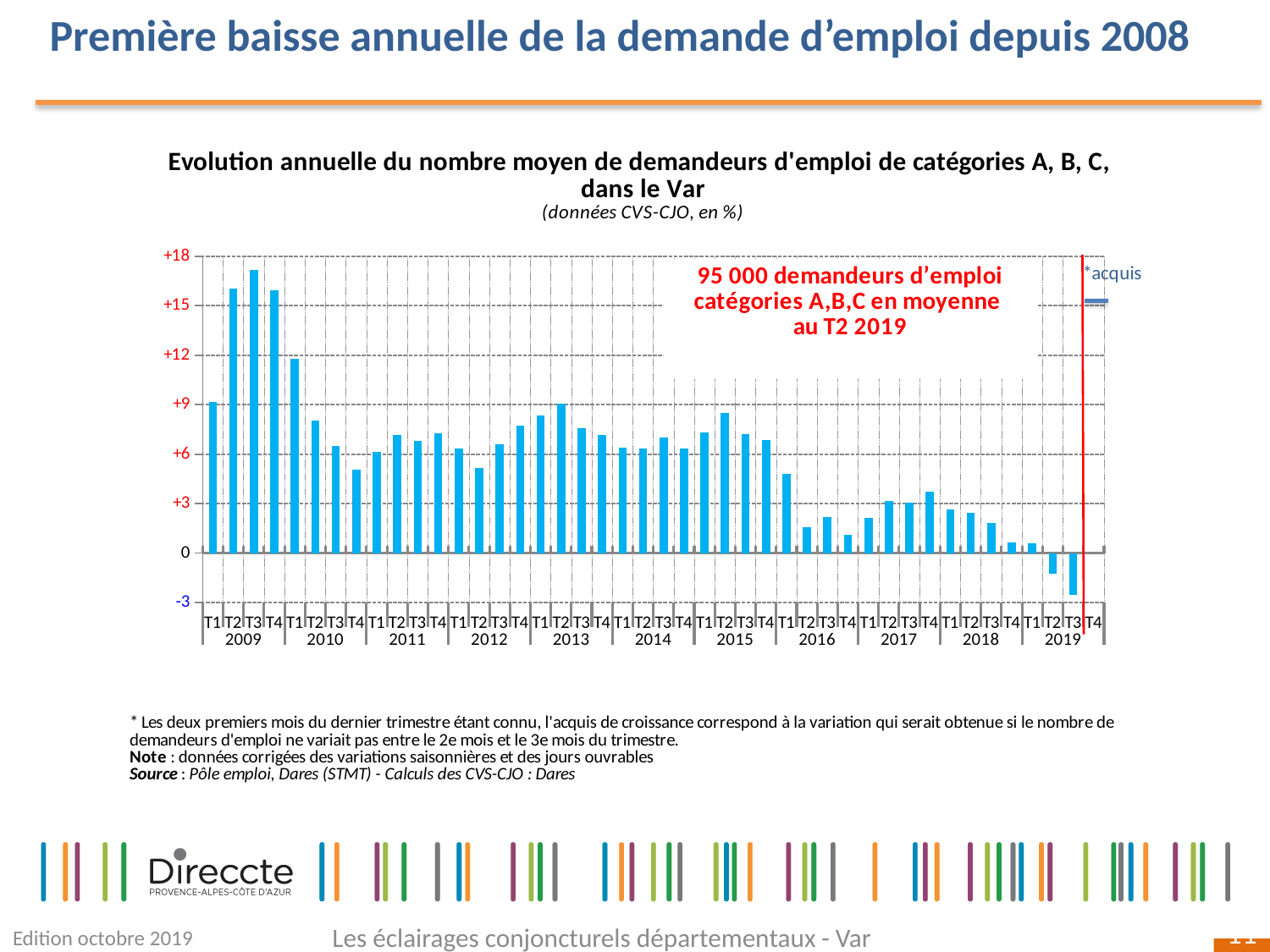
Is the value for T4 2010 greater or less than +6? less Do the values generally rise or fall from 2015 to 2019? fall What kind of chart is shown on the slide? bar chart Is the value for T3 2019 greater or less than 0? less Which quarter has the lowest value in the chart? T3 2019 According to the annotation on the chart, how many demandeurs d'emploi catégories A,B,C were there on average in T2 2019? 95 000 Is the value for T2 2010 greater or less than +9? less Which quarter has the highest value in the chart? T3 2009 How many years are labelled on the x axis? 11 Which is larger, the value for T2 2015 or the value for T1 2016? T2 2015